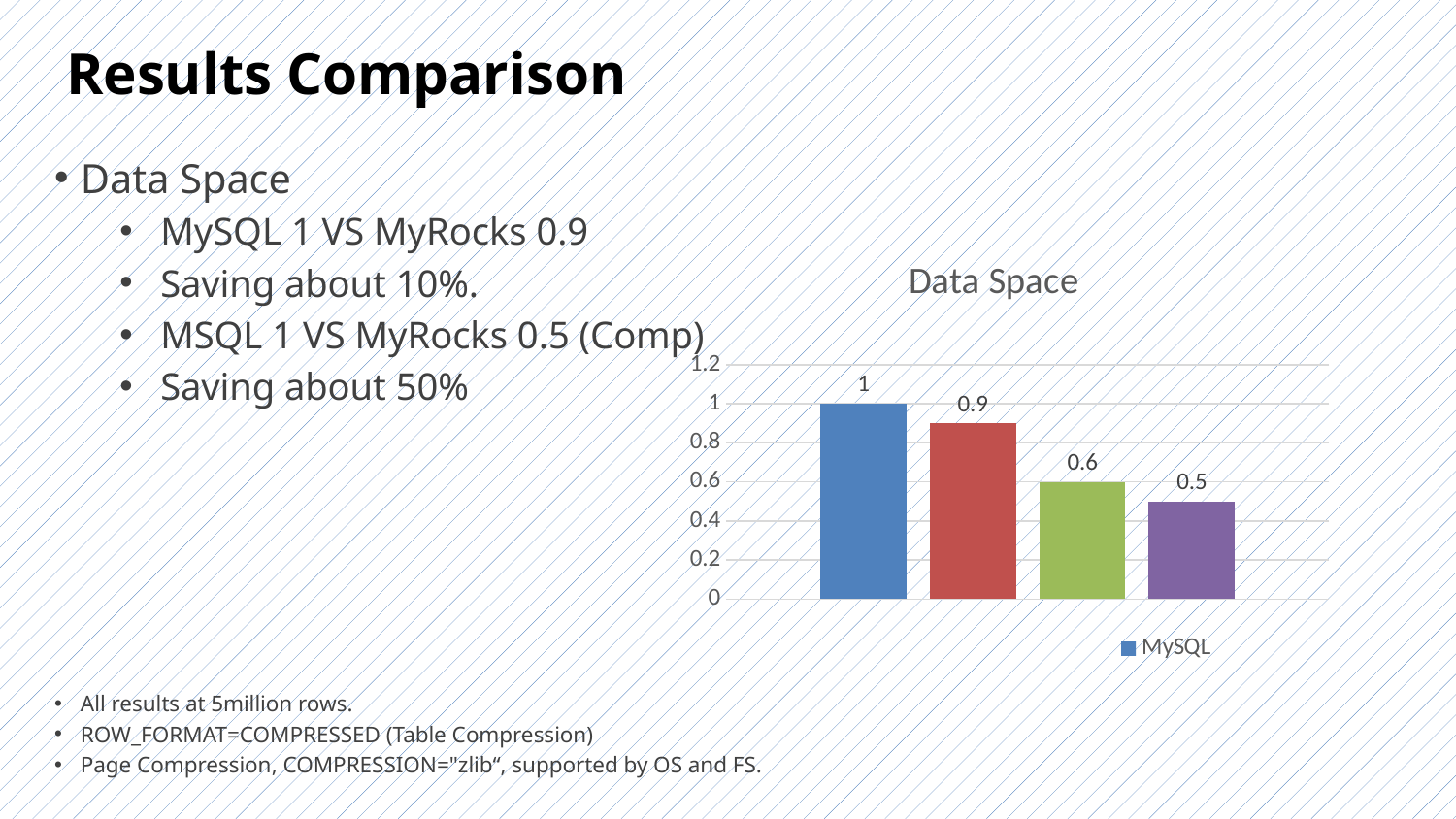
What is the value of the second (red) bar in the Data Space chart? 0.9 What is the title of the chart? Data Space What is the difference between the first bar and the last bar in the Data Space chart? 0.5 How many bars are plotted in the Data Space chart? 4 Do the bar values rise or fall from left to right in the Data Space chart? fall What is the value of the rightmost (purple) bar in the Data Space chart? 0.5 What is the value of the leftmost (blue) bar in the Data Space chart? 1 How many entries does the legend of the Data Space chart list? 1 What is the value of the third (green) bar in the Data Space chart? 0.6 What kind of chart is shown on the slide? bar chart Which bar in the Data Space chart has the lowest value? the rightmost (purple) bar What is the name of the series shown in the legend of the Data Space chart? MySQL